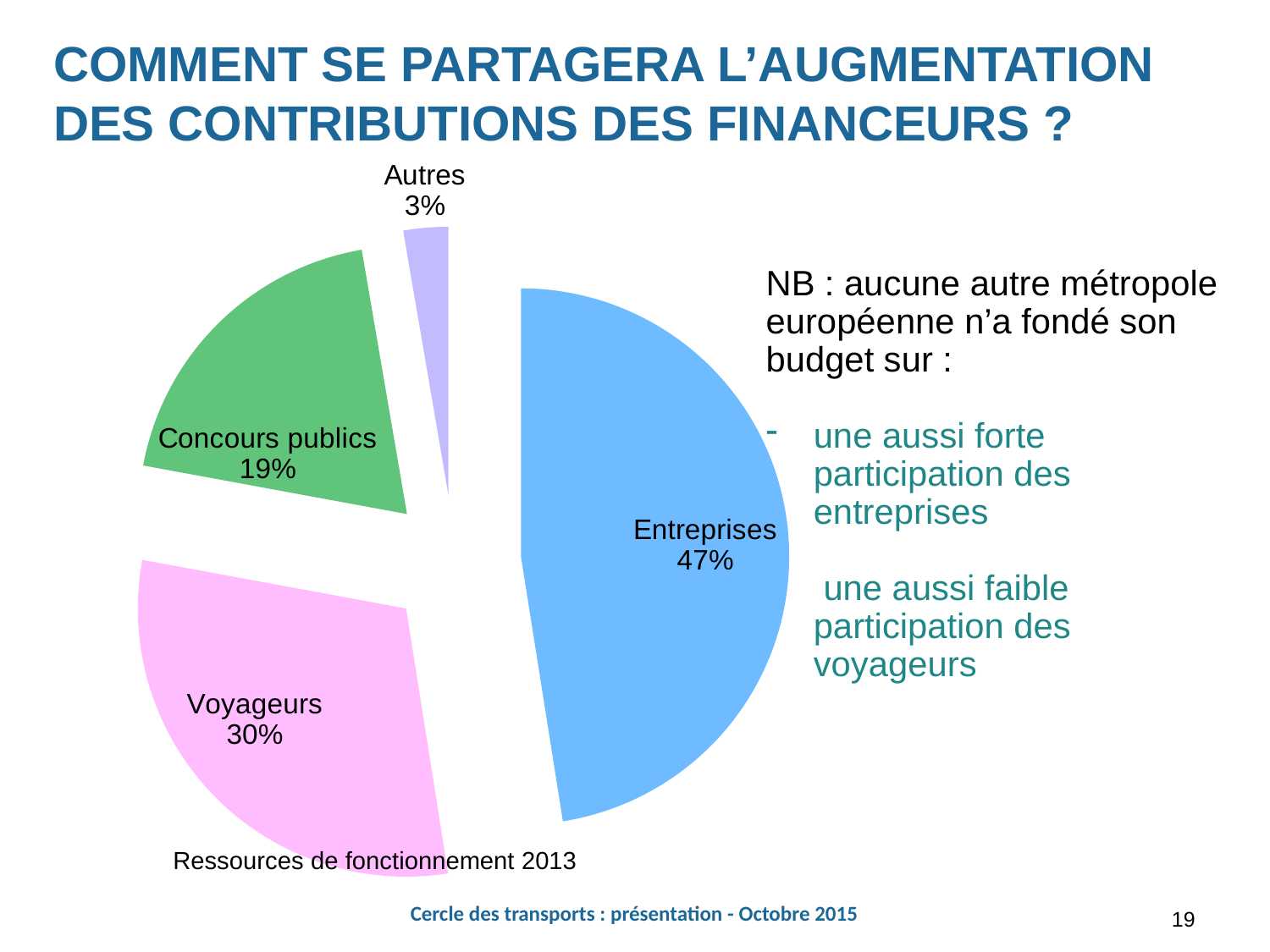
Which category has the smallest slice of the pie? Autres What share of the pie does Autres represent? 3% What share of the pie does Voyageurs represent? 30% Which is larger, the share for Concours publics or the share for Voyageurs? Voyageurs Which category has the largest slice of the pie? Entreprises What share of the pie does Entreprises represent? 47% What kind of chart is shown on the slide? Pie chart What is the difference in percentage points between Entreprises and Voyageurs? 17 What is the difference in percentage points between Voyageurs and Concours publics? 11 How many categories are shown in the pie chart? 4 What colour is the Entreprises slice? Blue